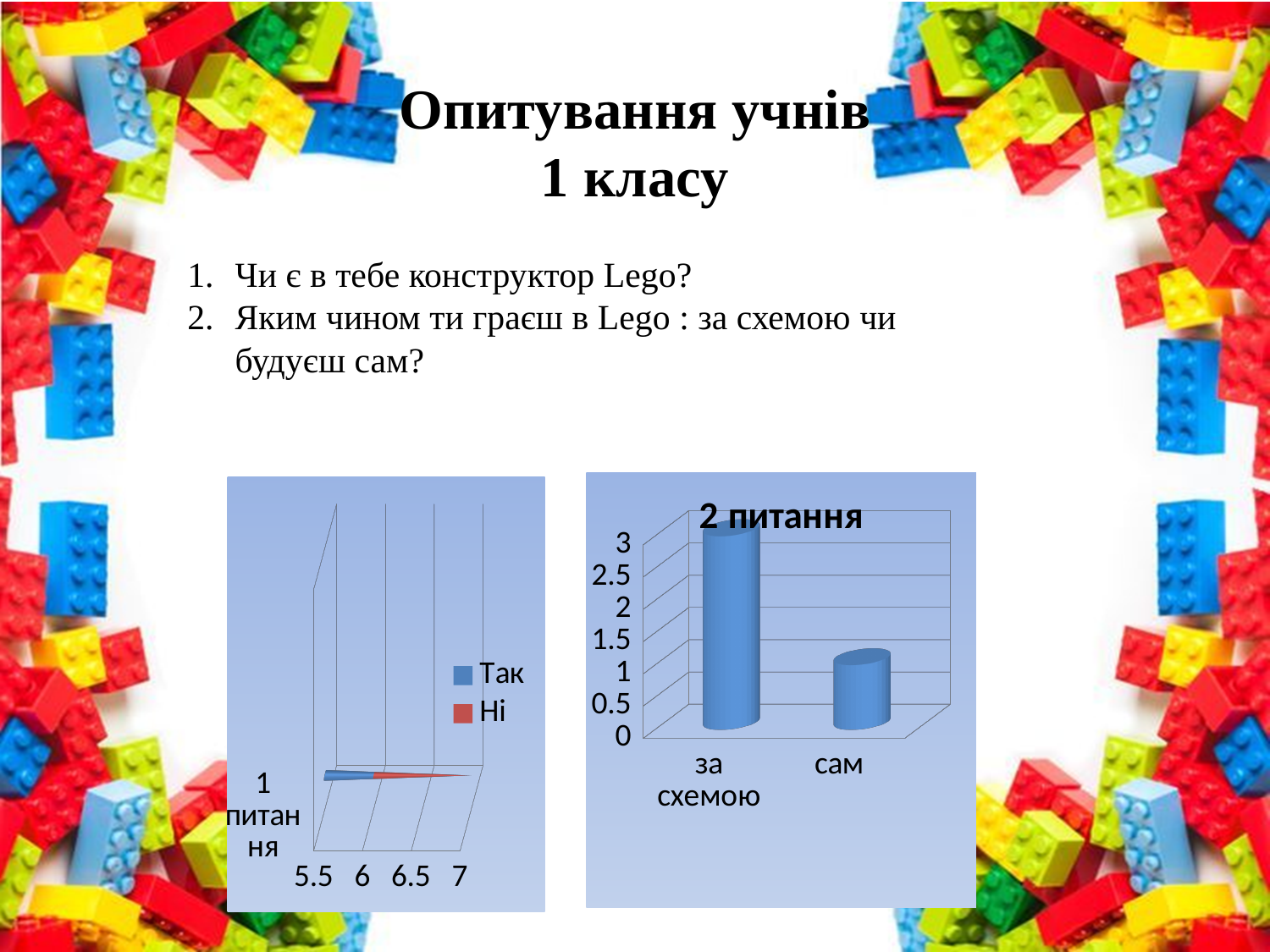
On the chart titled "2 питання", what is the difference between the values for "за схемою" and "сам"? 2 On the chart titled "2 питання", is the value for "за схемою" greater or less than 2? greater On the left chart, what are the legend entries? Так, Ні On the left chart, how many series does the legend list? 2 On the chart titled "2 питання", which category has the lower value? сам What kind of chart is the chart titled "2 питання"? bar chart On the chart titled "2 питання", how many categories are shown on the x axis? 2 On the chart titled "2 питання", which category has the higher value? за схемою On the chart titled "2 питання", what is the value for "сам"? 1 On the left chart, what is the label of the single category shown? 1 питання On the chart titled "2 питання", what is the value for "за схемою"? 3 On the chart titled "2 питання", is the value for "сам" greater or less than 2? less